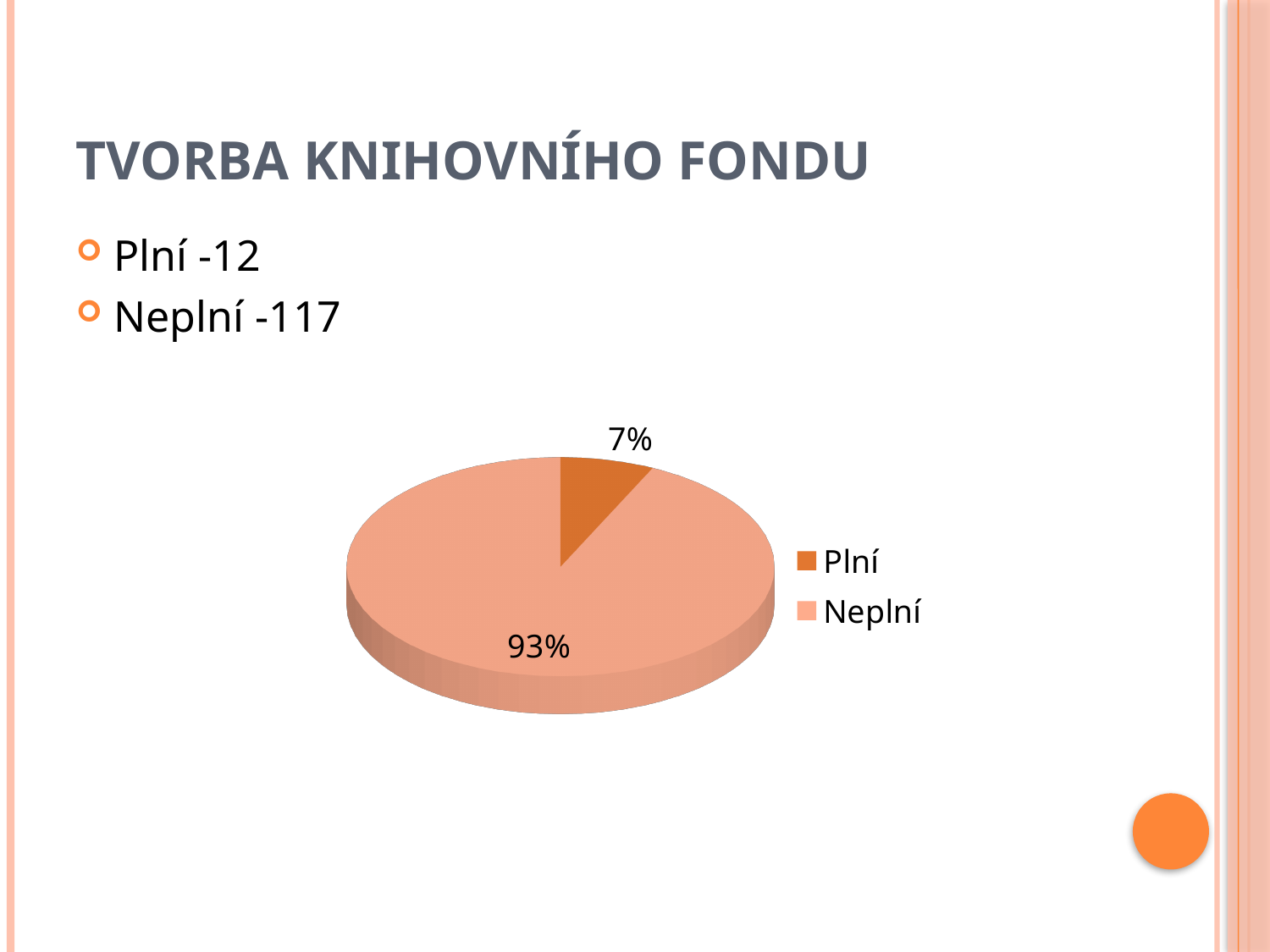
What share of the pie does the Plní slice represent? 7% What is the difference in percentage points between the Neplní and Plní slices? 86 What is the title of the slide containing the pie chart? Tvorba knihovního fondu Which category has the largest slice of the pie? Neplní Which category has the smallest slice of the pie? Plní Which category is shown in the darker orange colour? Plní What share of the pie does the Neplní slice represent? 93% How many slices does the pie chart have? 2 What kind of chart is shown on the slide? pie chart How many entries does the legend list? 2 Which slice is larger, Plní or Neplní? Neplní